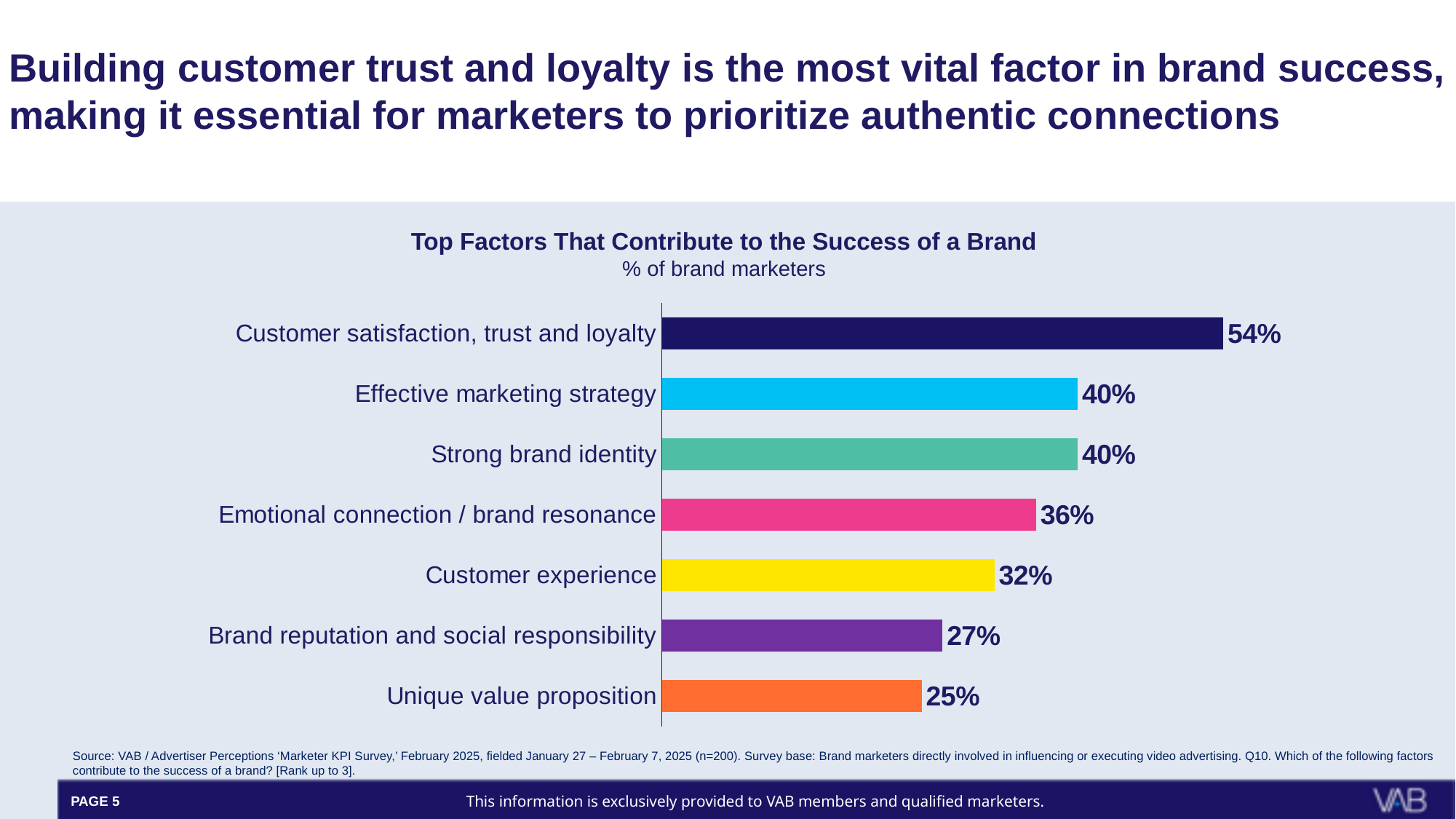
What is the value for Emotional connection / brand resonance? 36% Which factor has the highest percentage of brand marketers? Customer satisfaction, trust and loyalty What kind of chart is shown on the slide? Bar chart Which two factors share the same value of 40%? Effective marketing strategy and Strong brand identity What percentage of brand marketers cited customer satisfaction, trust and loyalty as a top factor? 54% Which is larger, the value for Customer experience or the value for Brand reputation and social responsibility? Customer experience What is the title of the chart? Top Factors That Contribute to the Success of a Brand What is the value for Brand reputation and social responsibility? 27% How many factors are shown in the chart? 7 What is the difference between the values for Customer satisfaction, trust and loyalty and Effective marketing strategy? 14% Which factor has the lowest percentage of brand marketers? Unique value proposition What is the difference between the values for Customer experience and Unique value proposition? 7%